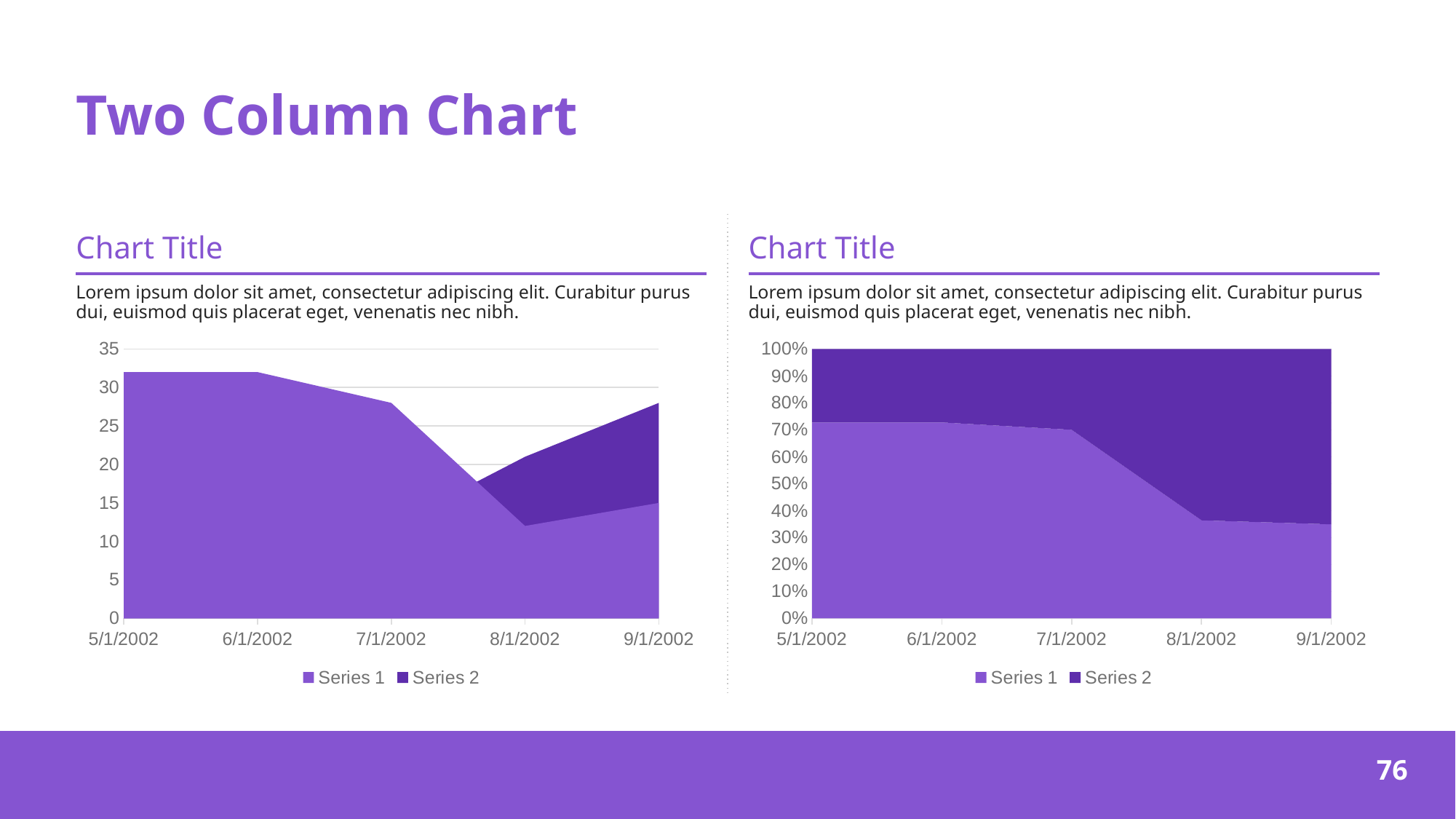
What kind of chart is the left chart on the slide? area chart What is the title shown above the right chart? Chart Title In the left chart, which date has the lowest value for Series 1? 8/1/2002 In the left chart, is the value for Series 1 at 8/1/2002 greater or less than 15? less In the left chart, does Series 1 rise or fall between 7/1/2002 and 8/1/2002? fall How many dates are shown on the x axis of the left chart? 5 How many series does the legend of the left chart list? 2 In the right chart, is the share of Series 1 at 9/1/2002 greater or less than 40%? less What kind of chart is the right chart on the slide? 100% stacked area chart How many series does the legend of the right chart list? 2 In the left chart, is the value for Series 1 at 5/1/2002 greater or less than 30? greater